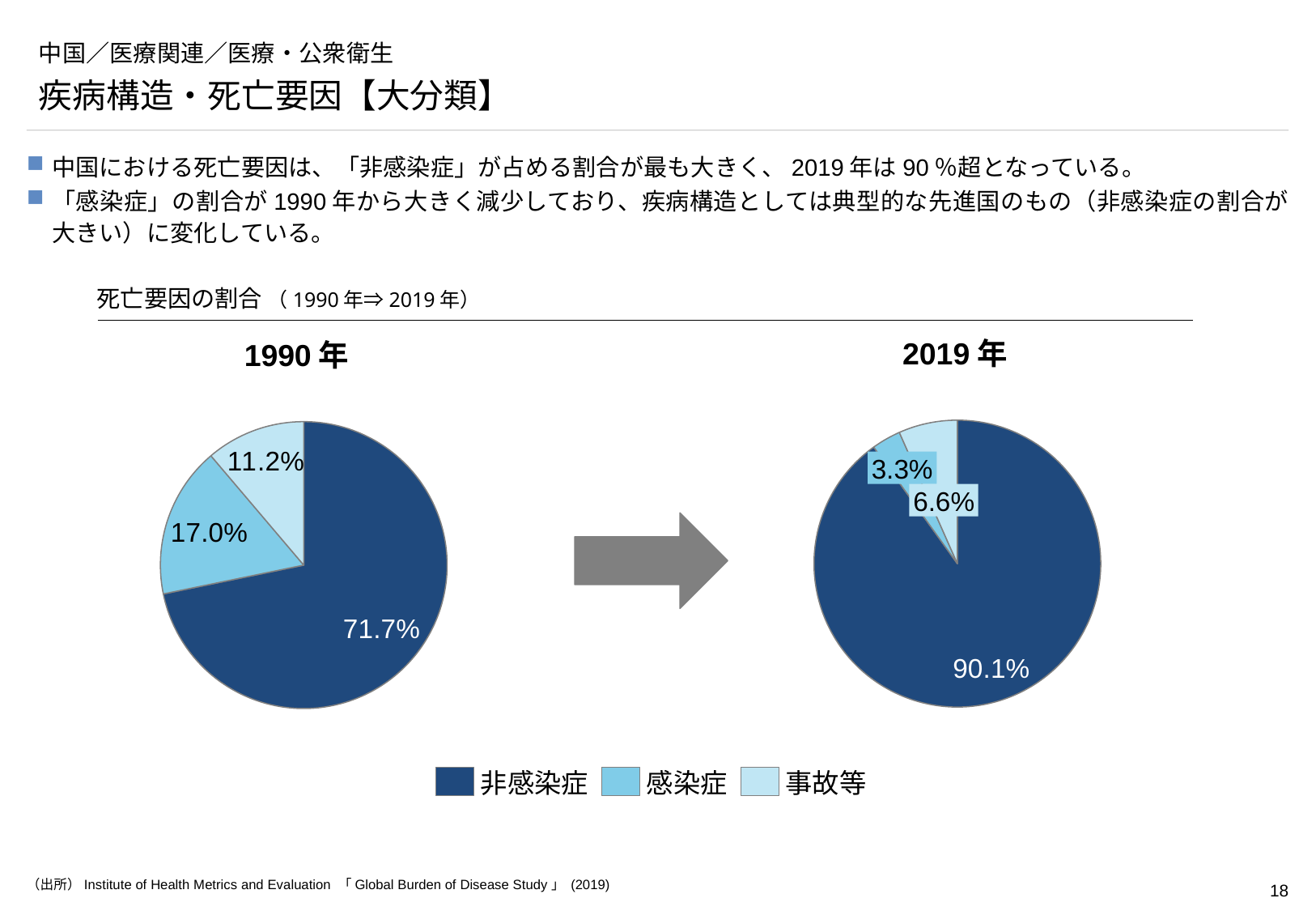
How many categories does the legend list for the pie charts? 3 What type of chart is used to show the 死亡要因の割合 for 1990年 and 2019年? Pie chart In the 1990年 pie chart, what share is shown for 感染症? 17.0% In the 1990年 pie chart, what share is shown for 非感染症? 71.7% In the 2019年 pie chart, what share is shown for 感染症? 3.3% By how many percentage points did the share of 非感染症 increase from the 1990年 pie chart to the 2019年 pie chart? 18.4 In the 1990年 pie chart, what share is shown for 事故等? 11.2% In the 2019年 pie chart, what share is shown for 事故等? 6.6% In the 1990年 pie chart, which category has the largest share? 非感染症 In the 2019年 pie chart, which category has the smallest share? 感染症 In the 2019年 pie chart, what share is shown for 非感染症? 90.1% In the 2019年 pie chart, which is larger: the share of 感染症 or the share of 事故等? 事故等